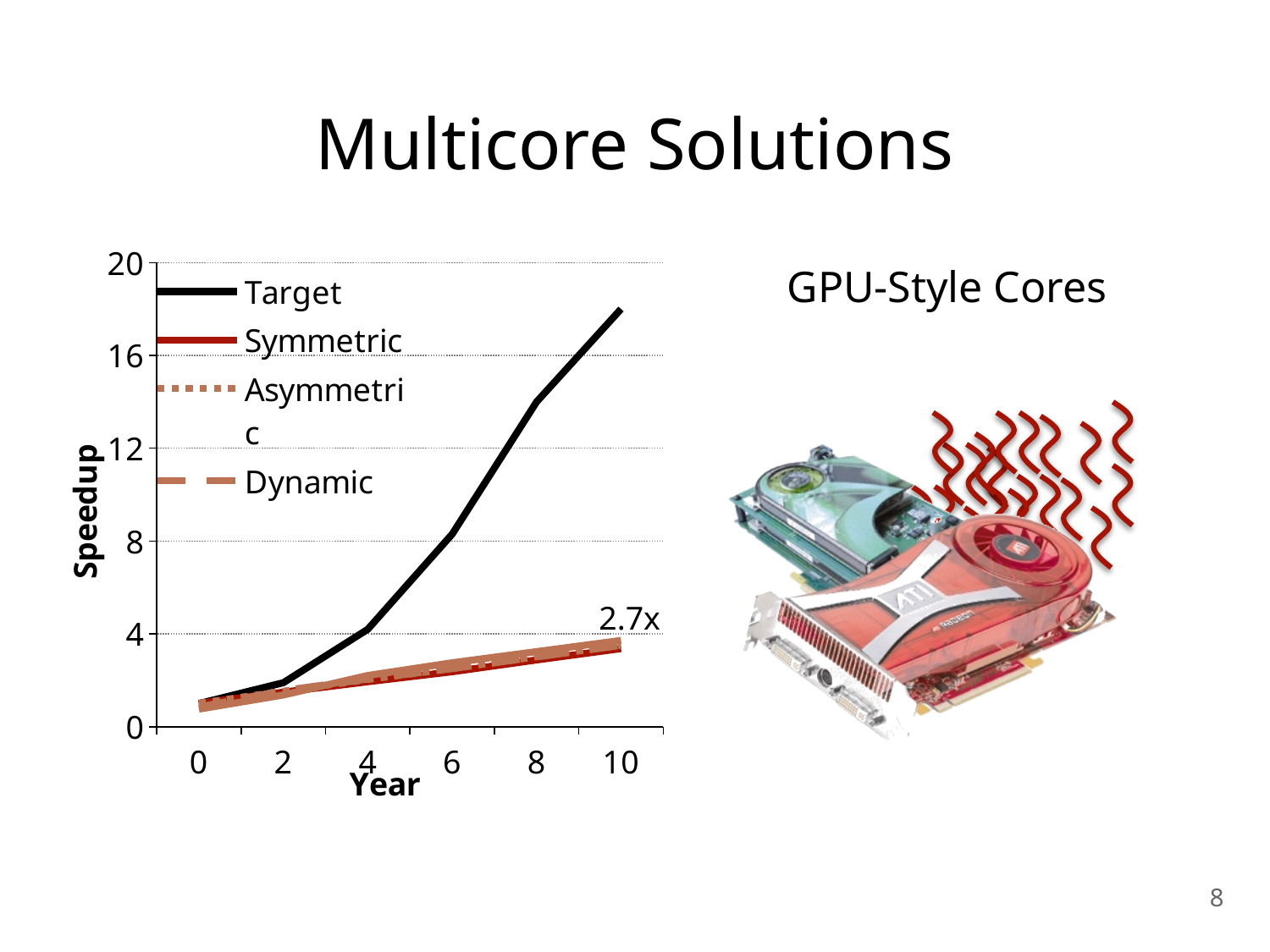
Which series has the highest speedup at year 10? Target What is the label of the vertical axis of the chart? Speedup Is the Target speedup at year 10 greater or less than 16? greater Is the Target speedup at year 4 greater or less than 8? less Is the Target speedup at year 8 greater or less than 12? greater What kind of chart is shown on the slide? line chart What is the highest value shown on the Speedup axis? 20 Which series are listed in the chart legend? Target, Symmetric, Asymmetric, Dynamic Does the Target series rise or fall as Year increases? rise How many series does the chart legend list? 4 At year 10, which series has the higher speedup, Target or Dynamic? Target